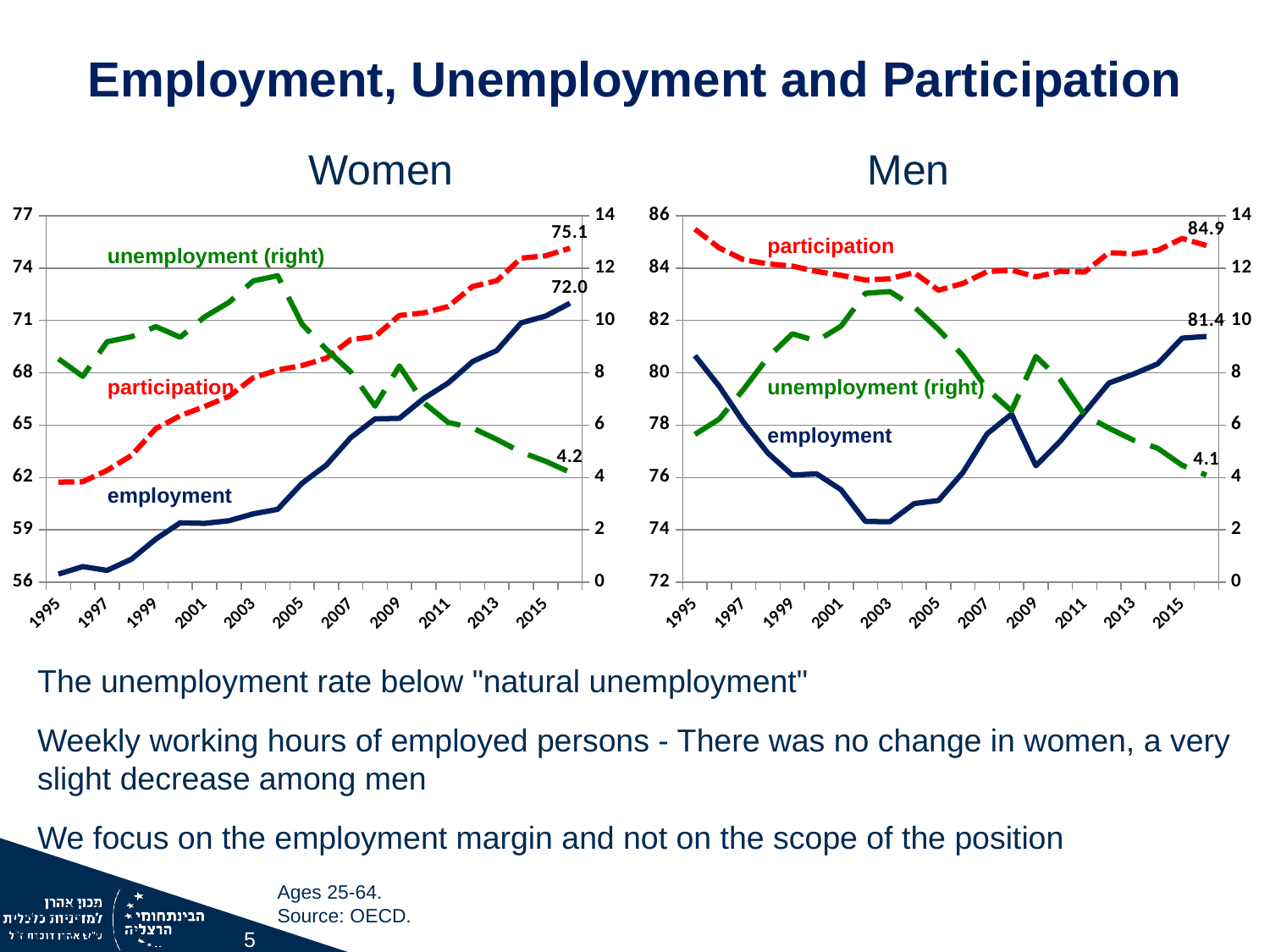
In the Women chart, what is the final labelled value of the participation series? 75.1 In the Men chart, what is the final labelled value of the employment series? 81.4 In the Women chart, does the employment series rise or fall overall from 1995 to the end of the period? rise In the Men chart, what is the final labelled value of the unemployment (right) series? 4.1 In the Women chart, is the employment value in 1995 greater or less than 59? less In the Men chart, what is the final labelled value of the participation series? 84.9 In the Women chart, what is the final labelled value of the employment series? 72.0 What type of chart is the Men chart? line chart In the Women chart, what is the difference between the final labelled participation value and the final labelled employment value? 3.1 Which chart shows a higher final labelled employment value, Women or Men? Men In the Women chart, what is the final labelled value of the unemployment (right) series? 4.2 In the Men chart, what is the difference between the final labelled participation value and the final labelled employment value? 3.5